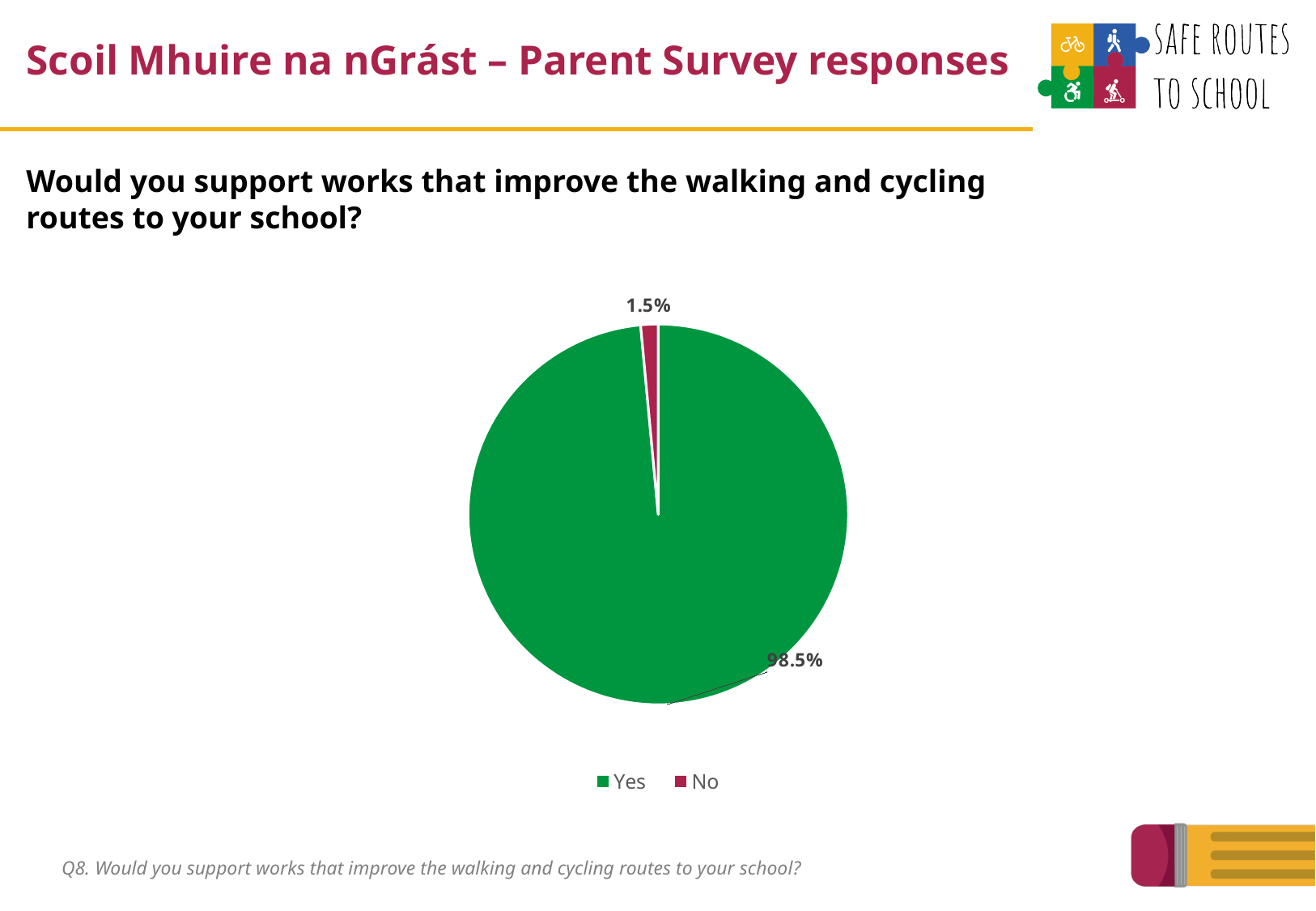
Which response has the largest share of the pie? Yes How many categories does the pie chart show? 2 What colour is the Yes slice? green What colour is the No slice? red What percentage of parents answered No? 1.5% What kind of chart is shown on the slide? pie chart What percentage of parents answered Yes? 98.5% Which is larger, the share for Yes or the share for No? Yes Which response has the smallest share of the pie? No How many entries does the legend list? 2 What is the difference in percentage points between the Yes and No responses? 97 percentage points What share of the pie does the No slice represent? 1.5%